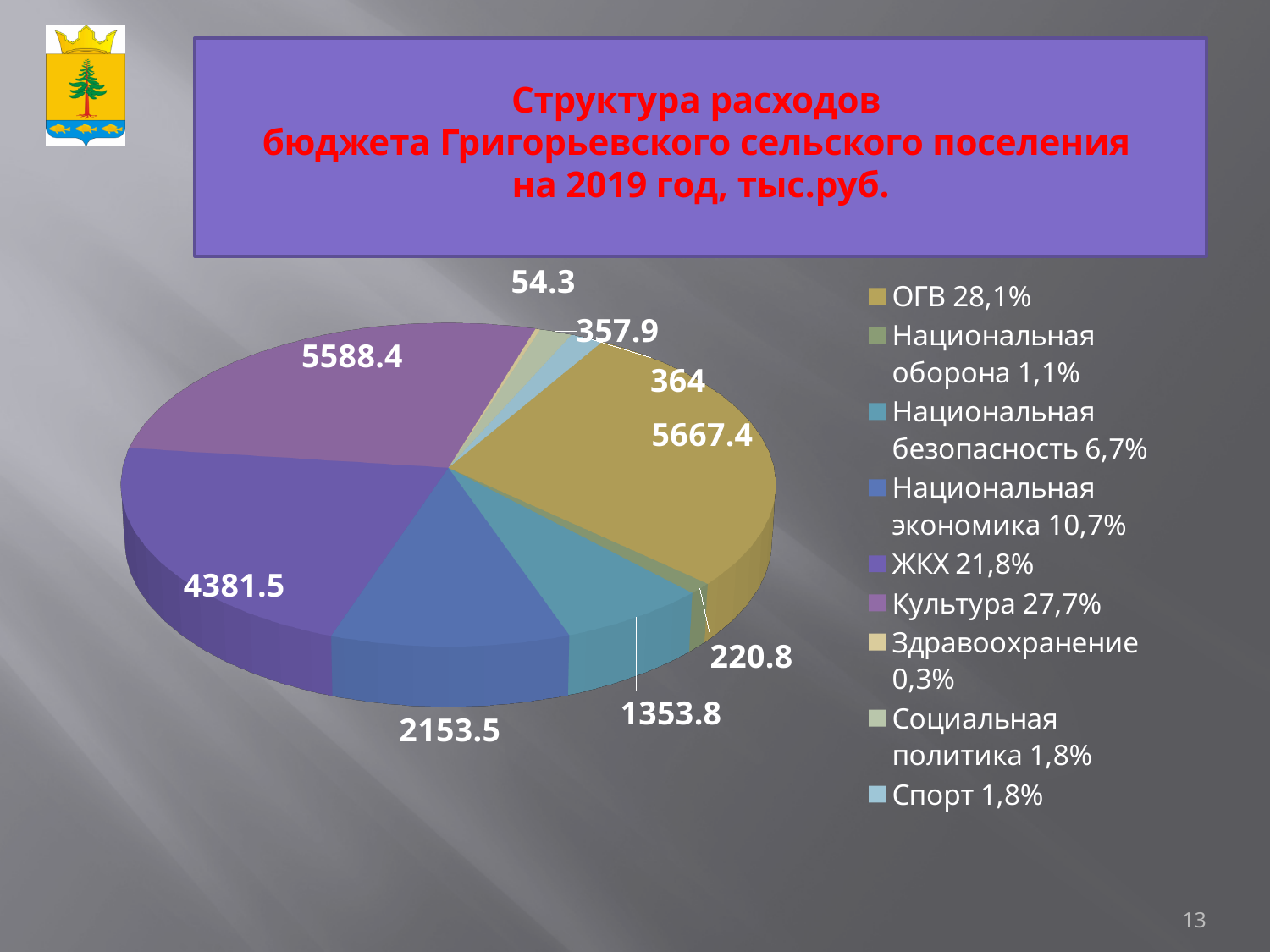
What is the value shown for the Здравоохранение slice? 54.3 What share of the pie does the Культура slice represent, according to the legend? 27,7% What is the value shown for the ОГВ slice? 5667.4 What is the difference between the ЖКХ value and the Национальная экономика value? 2228 What kind of chart is shown on the slide? pie chart Which category has the largest value in the pie chart? ОГВ What is the value shown for the Культура slice? 5588.4 Which category has the smallest value in the pie chart? Здравоохранение How many categories does the legend of the pie chart list? 9 What is the value shown for the Национальная экономика slice? 2153.5 What is the value shown for the ЖКХ slice? 4381.5 Which is larger, the value for ЖКХ or the value for Национальная безопасность? ЖКХ